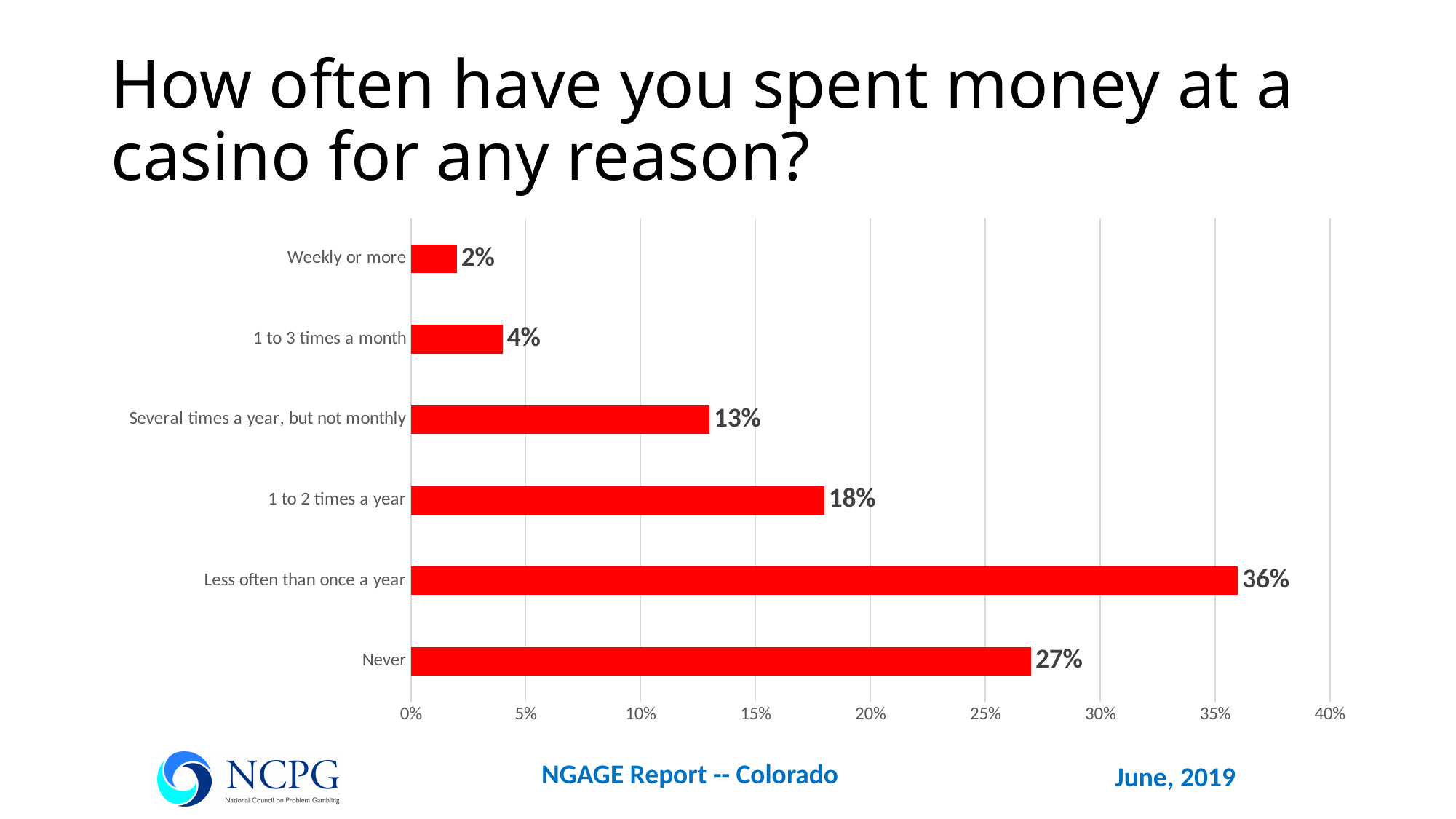
Which category has the lowest value? Weekly or more What is the maximum value shown on the horizontal axis? 40% Which is larger: "1 to 2 times a year" or "Several times a year, but not monthly"? 1 to 2 times a year How many categories are shown in the chart? 6 What is the value for "Several times a year, but not monthly"? 13% What is the difference between "Less often than once a year" and "Never"? 9% Which category has the highest value? Less often than once a year Is the value for "Never" greater or less than 25%? greater What kind of chart is shown on the slide? Bar chart What percentage of respondents said they spent money at a casino weekly or more? 2% What is the value for "1 to 2 times a year"? 18% What percentage of respondents answered "Never"? 27%